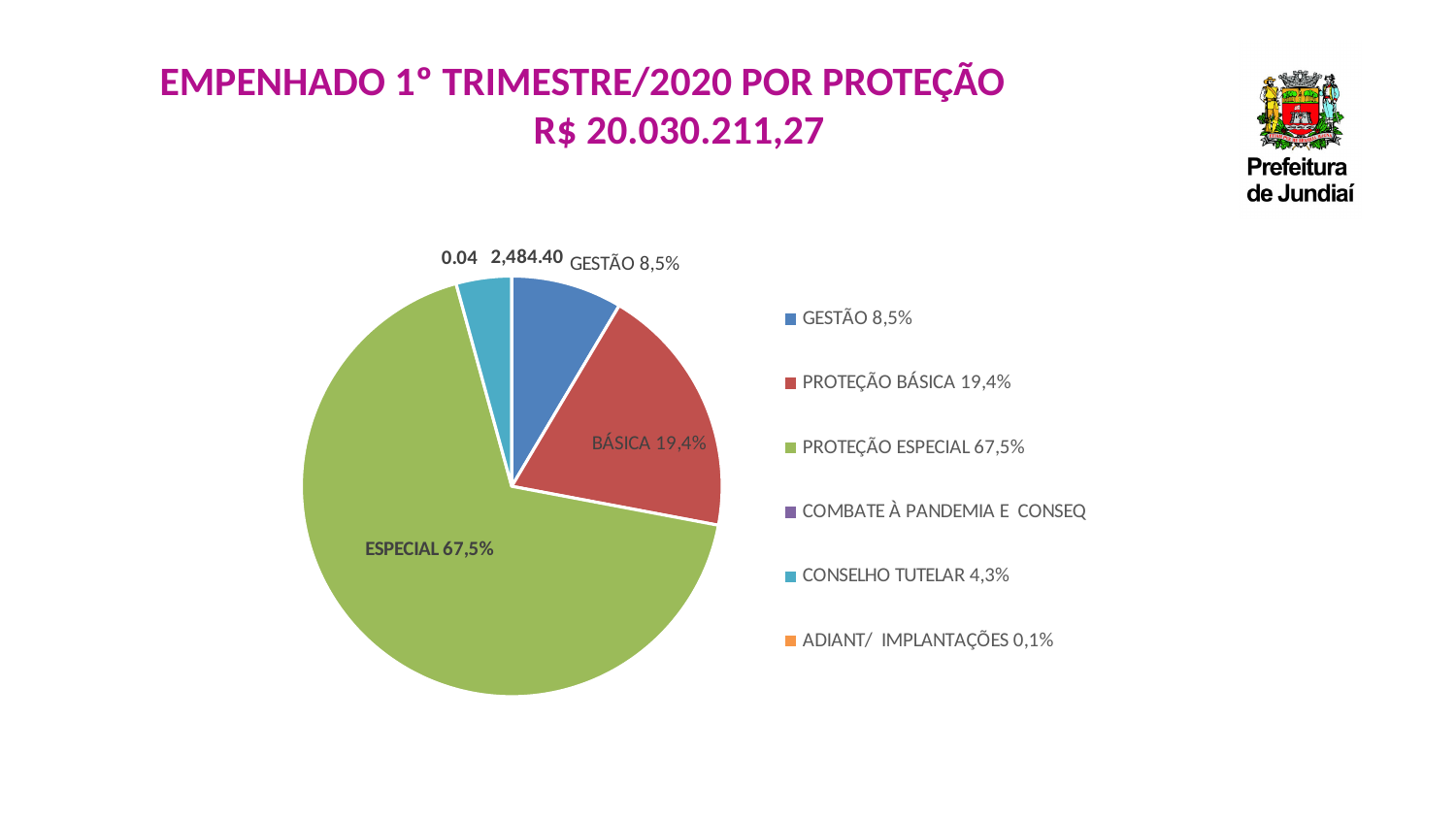
Which is larger, the share for GESTÃO or the share for PROTEÇÃO BÁSICA? PROTEÇÃO BÁSICA What percentage is shown for CONSELHO TUTELAR in the legend? 4,3% What share of the pie does PROTEÇÃO ESPECIAL represent, according to the legend? 67,5% Which category has the smallest percentage listed in the legend? ADIANT/ IMPLANTAÇÕES What colour is the PROTEÇÃO ESPECIAL slice of the pie? green What percentage is shown for GESTÃO in the legend? 8,5% What total amount in R$ is stated in the chart title? R$ 20.030.211,27 Which category has the largest share of the pie? PROTEÇÃO ESPECIAL What kind of chart is shown on the slide? pie chart What is the difference in percentage points between PROTEÇÃO ESPECIAL (67,5%) and PROTEÇÃO BÁSICA (19,4%)? 48,1 How many entries does the legend of the pie chart list? 6 What percentage is shown for PROTEÇÃO BÁSICA in the legend? 19,4%